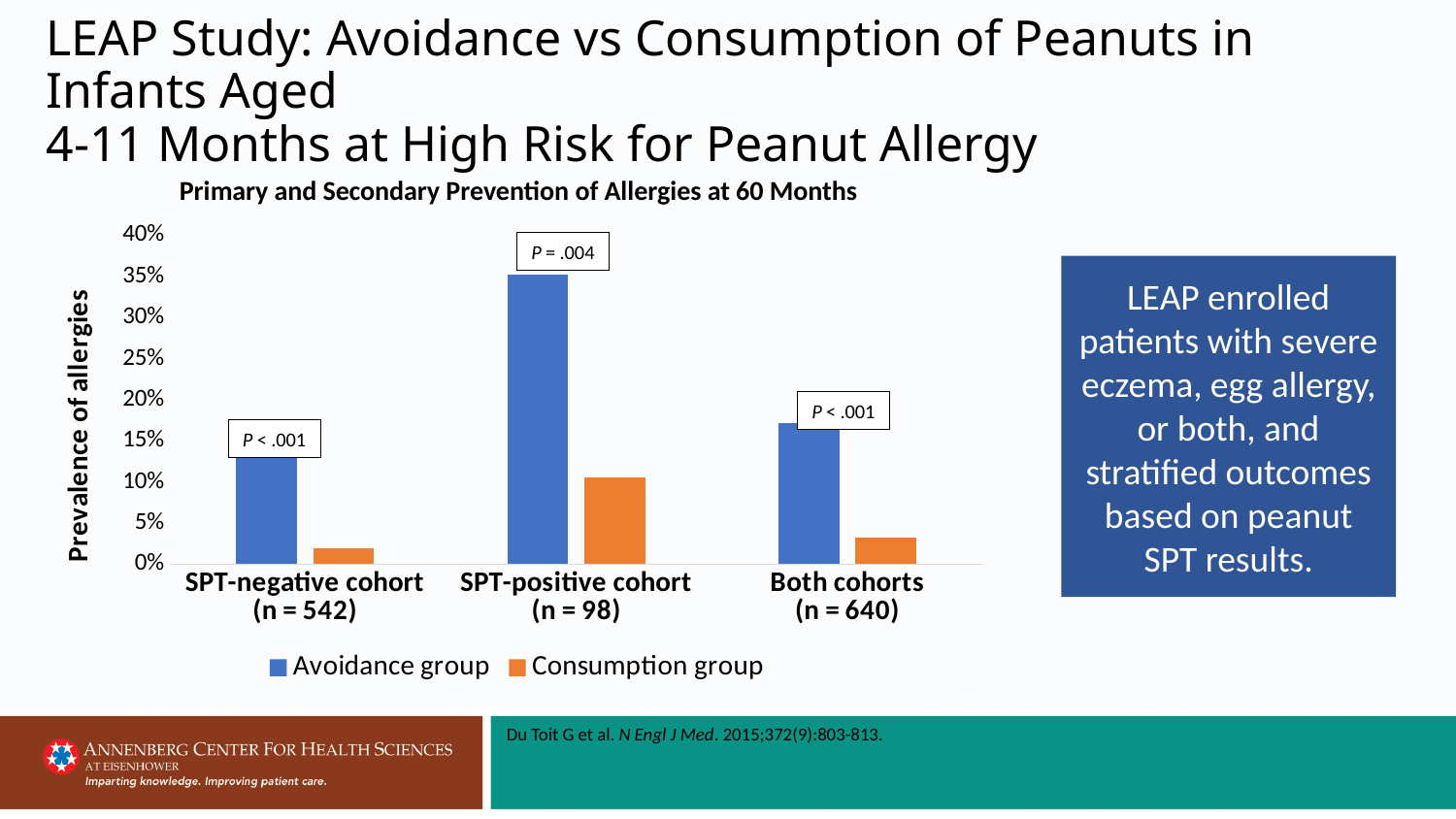
Which cohort has the highest prevalence of allergies in the Avoidance group? SPT-positive cohort What kind of chart is shown on the slide? bar chart Which cohort has the lowest prevalence of allergies in the Consumption group? SPT-negative cohort How many series does the legend list? 2 What is the title of the chart? Primary and Secondary Prevention of Allergies at 60 Months In the SPT-negative cohort, which group has the higher prevalence of allergies, Avoidance or Consumption? Avoidance group What P value is shown above the SPT-positive cohort bars? P = .004 Is the Consumption group value for Both cohorts greater or less than 5%? less How many cohort categories are plotted on the x axis? 3 Which has the higher Avoidance group prevalence, the SPT-negative cohort or Both cohorts? Both cohorts Is the Avoidance group value for the SPT-positive cohort greater or less than 30%? greater Is the Avoidance group value for the SPT-negative cohort greater or less than 10%? greater